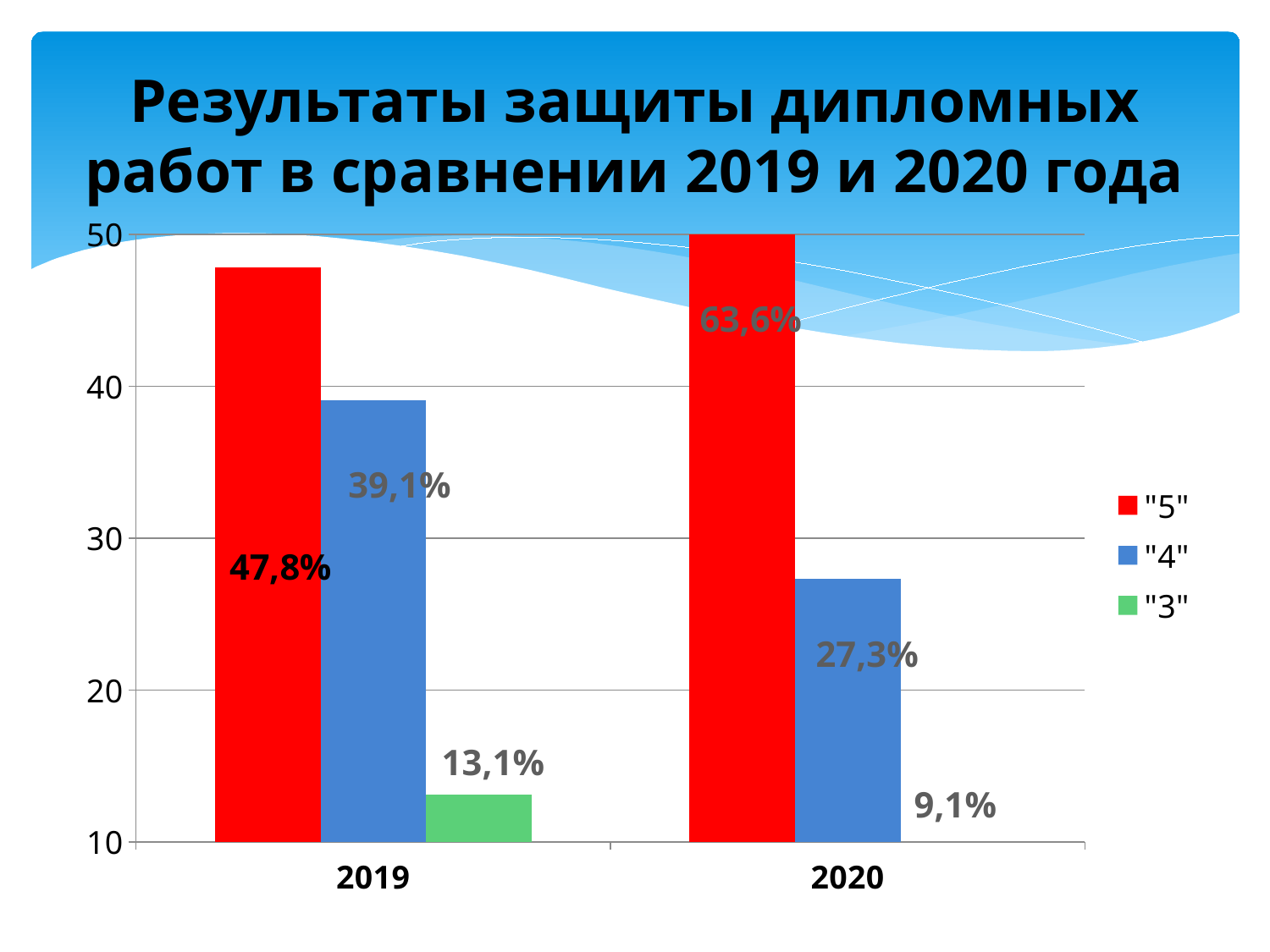
How many series does the legend list? 3 What is the value for "4" in 2020? 27,3% What is the value for "5" in 2019? 47,8% How many categories are shown on the x axis? 2 What is the value for "5" in 2020? 63,6% What kind of chart is shown on the slide? Bar chart Which series has the highest value in 2020? "5" What colour represents the "3" series in the legend? Green Which is larger: the "4" value in 2019 or the "4" value in 2020? 2019 What is the value for "3" in 2019? 13,1% What is the difference between the "5" values for 2020 and 2019? 15,8% Which series has the lowest value in 2019? "3"